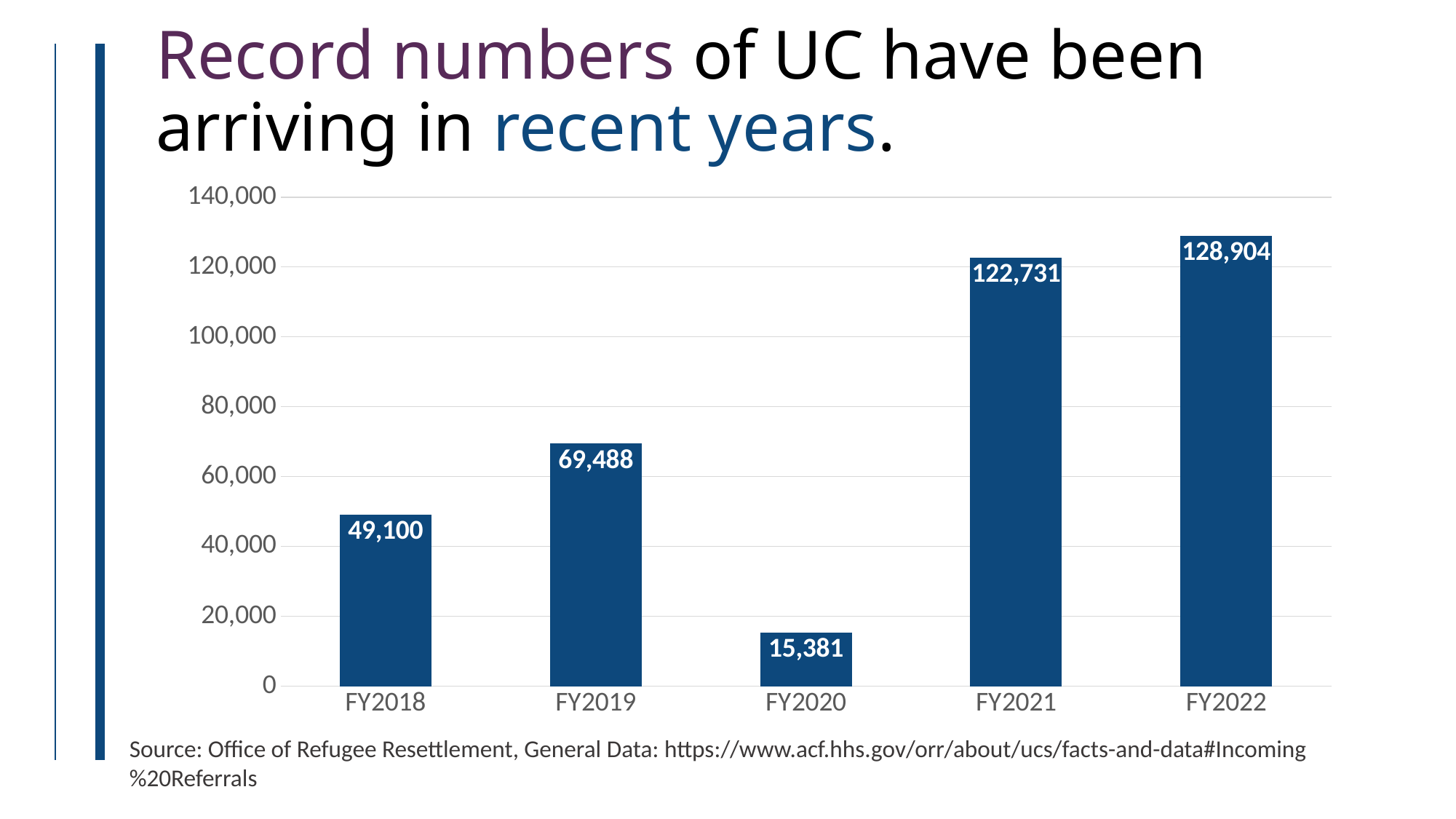
What is the difference between the values for FY2022 and FY2021? 6,173 What is the value for FY2020? 15,381 What kind of chart is shown on the slide? bar chart What is the difference between the values for FY2019 and FY2018? 20,388 What is the value for FY2018? 49,100 Do the values rise or fall from FY2020 to FY2022? rise Which is larger, the value for FY2019 or the value for FY2020? FY2019 How many fiscal years are shown on the chart? 5 Which fiscal year has the lowest value? FY2020 Which fiscal year has the highest value? FY2022 What is the value for FY2022? 128,904 Is the value for FY2021 greater or less than 120,000? greater